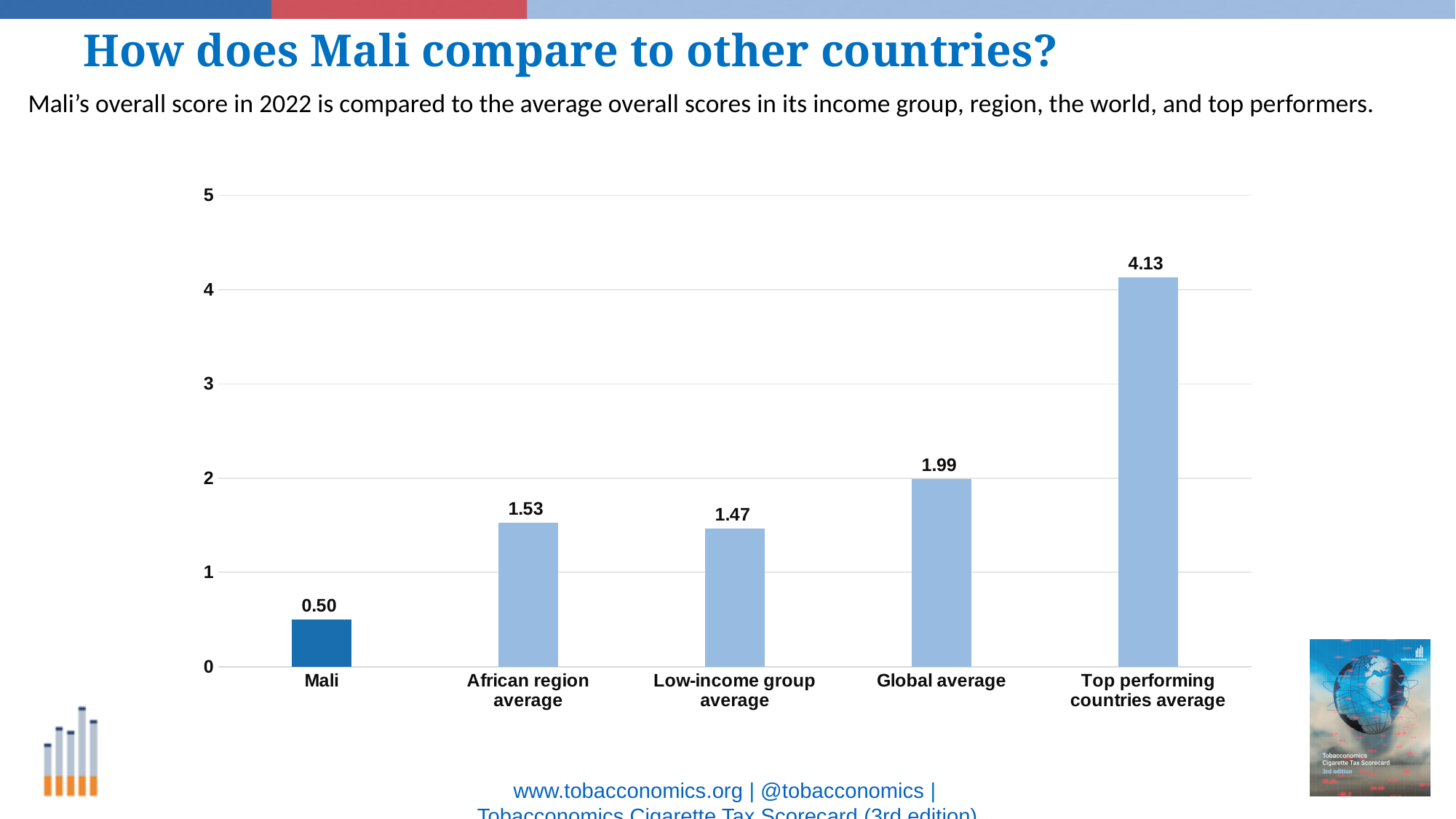
How many categories are shown on the chart? 5 What is the difference between the Top performing countries average and Mali? 3.63 Is the value for the Global average greater or less than 1? greater What is the value for the Global average? 1.99 Which category has the lowest value? Mali What is the value for the Top performing countries average? 4.13 What is the value for the Low-income group average? 1.47 What is the value for the African region average? 1.53 Which category has the highest value? Top performing countries average What is the value for Mali? 0.50 What kind of chart is shown on the slide? Bar chart Which is larger, the Global average or the African region average? Global average